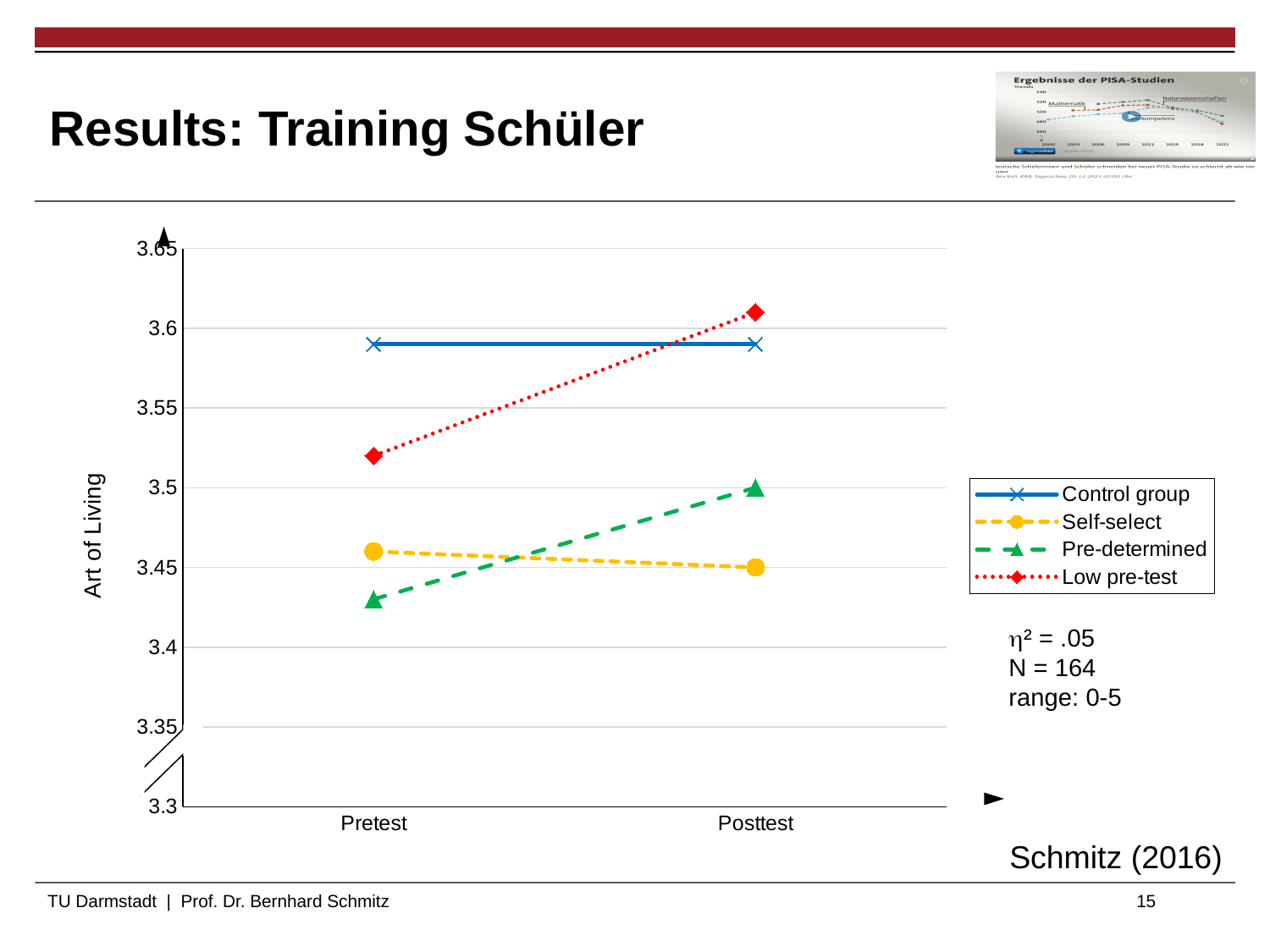
Which group has the lowest value at Pretest? Pre-determined What is the label of the y axis? Art of Living Is the value for Pre-determined at Pretest greater or less than 3.45? less Which group has the highest value at Posttest? Low pre-test Does the Control group line rise, fall or stay flat from Pretest to Posttest? stay flat Does the Pre-determined line rise or fall from Pretest to Posttest? rise How many series does the legend list? 4 Does the Low pre-test line rise or fall from Pretest to Posttest? rise At Pretest, which is larger: the Control group value or the Low pre-test value? Control group What kind of chart is shown on the slide? line chart How many categories are shown on the x axis? 2 Is the value for the Control group at Pretest greater or less than 3.55? greater